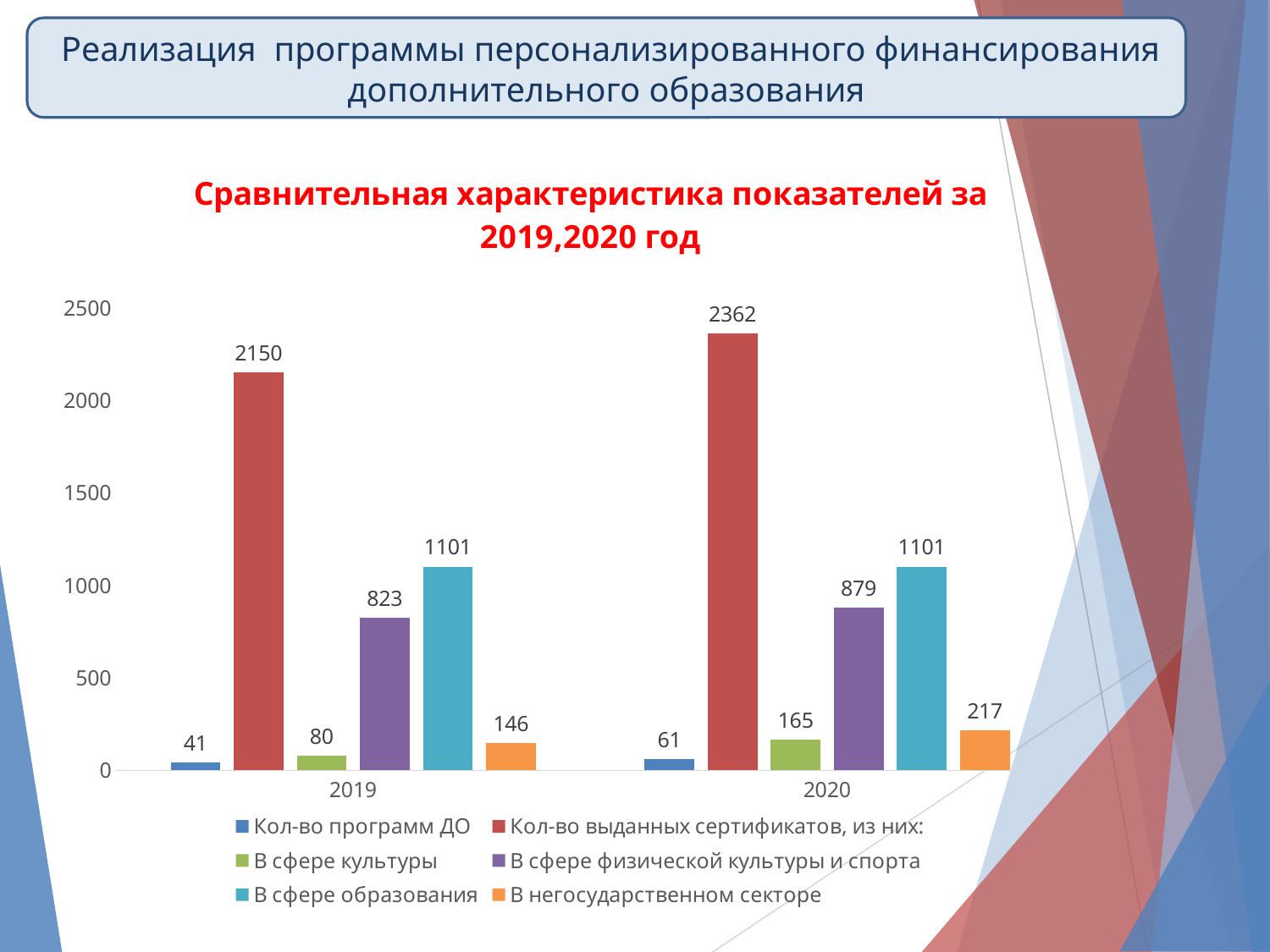
What kind of chart is shown on the slide? Bar chart What is the difference between the 'Кол-во выданных сертификатов, из них:' values for 2020 and 2019? 212 Which series has the highest value in 2020? Кол-во выданных сертификатов, из них: How many series does the legend list? 6 What is the title of the chart? Сравнительная характеристика показателей за 2019,2020 год What is the value for 'В негосударственном секторе' in 2020? 217 Which is larger: 'В сфере культуры' in 2019 or 'В сфере культуры' in 2020? 2020 What is the value for 'Кол-во выданных сертификатов, из них:' in 2019? 2150 Is the value for 'В сфере образования' in 2019 greater or less than 1000? greater What is the value for 'Кол-во программ ДО' in 2019? 41 Which series has the lowest value in 2019? Кол-во программ ДО What is the value for 'В сфере физической культуры и спорта' in 2020? 879